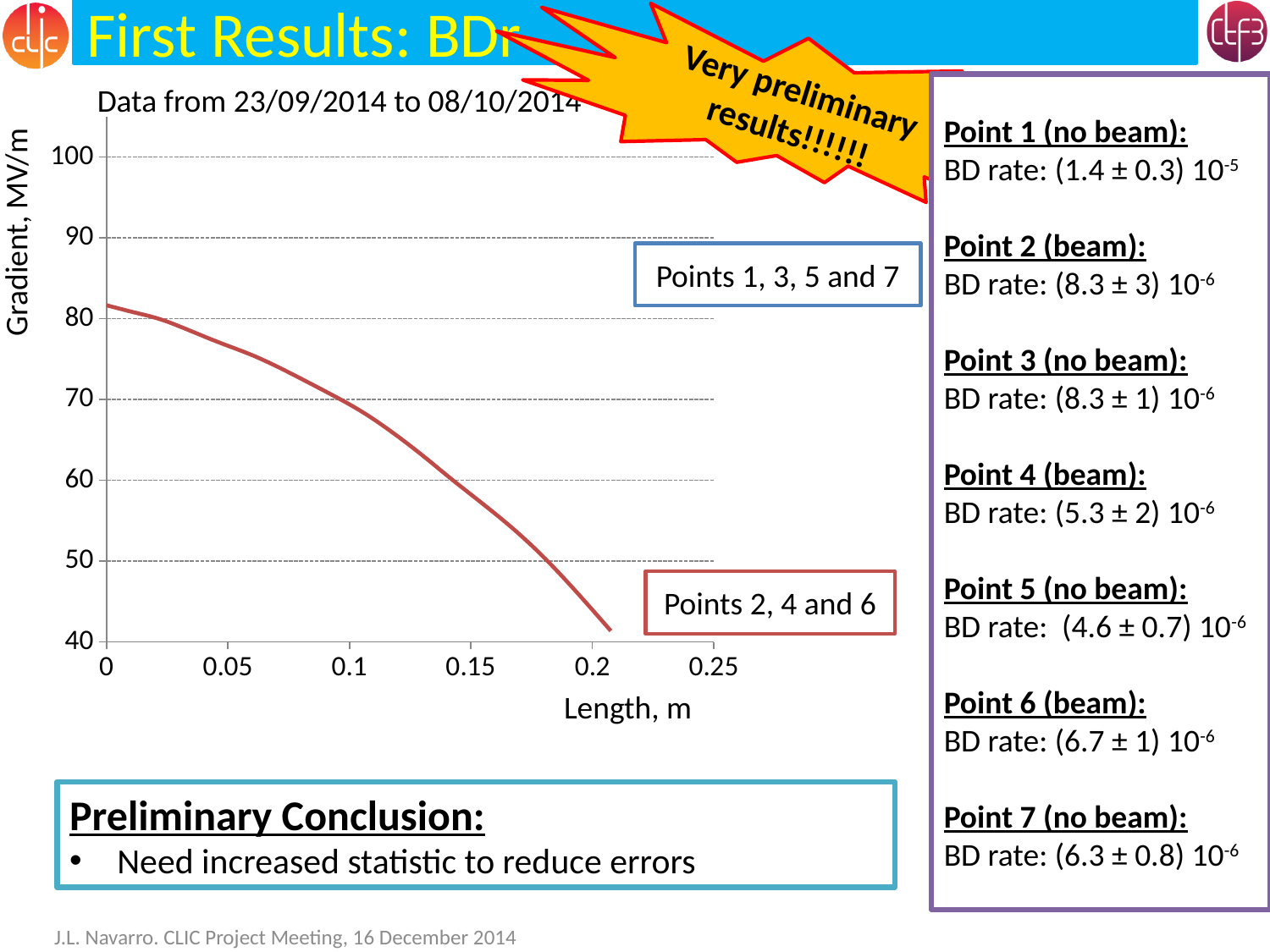
How many lines are plotted on the chart? 1 Is the gradient at a length of 0 m greater or less than 70 MV/m? greater What is the label of the y axis of the chart? Gradient, MV/m What kind of chart is shown on the slide? line chart Is the gradient at a length of 0.2 m greater or less than 60 MV/m? less What is the largest length value shown on the x axis of the chart? 0.25 Does the gradient rise or fall as the length increases along the x axis? fall What is the highest value shown on the y axis of the chart? 100 What is the label of the x axis of the chart? Length, m Is the gradient at a length of 0.05 m greater or less than 70 MV/m? greater